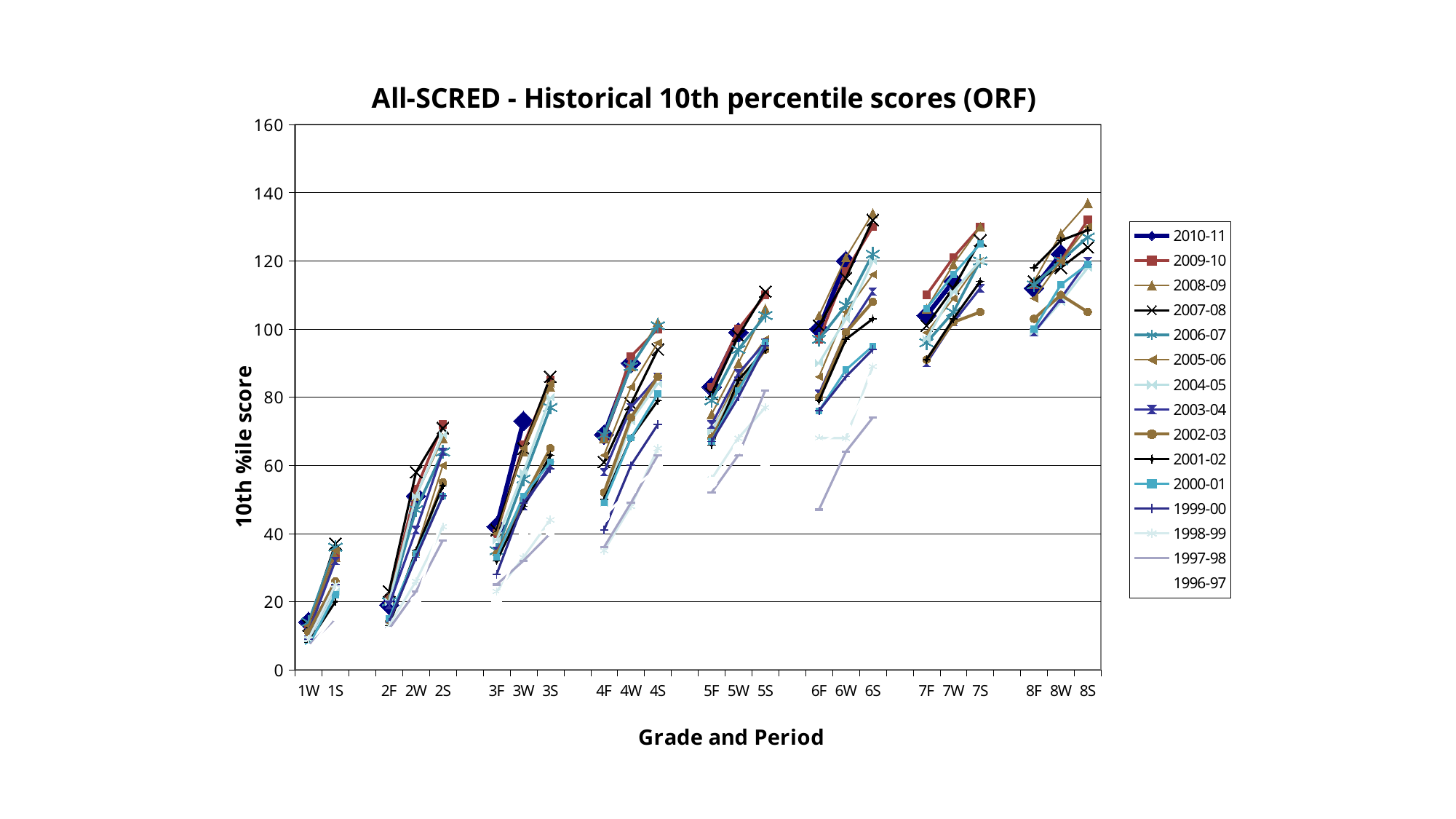
Which series has the lowest value at 6F? 1997-98 Is the value for 2008-09 at 8S greater or less than 120? greater Do the 10th percentile scores generally rise or fall from 1W to 8S along the x axis? rise Is the value for 2009-10 at 7S greater or less than 120? greater Which series has the highest value at 8S? 2008-09 How many series does the legend list? 15 How many categories are shown on the x axis? 23 What kind of chart is shown on the slide? line chart Is the value for 1998-99 at 6S greater or less than 100? less What is the title of the chart? All-SCRED - Historical 10th percentile scores (ORF) What is the label of the y axis? 10th %ile score